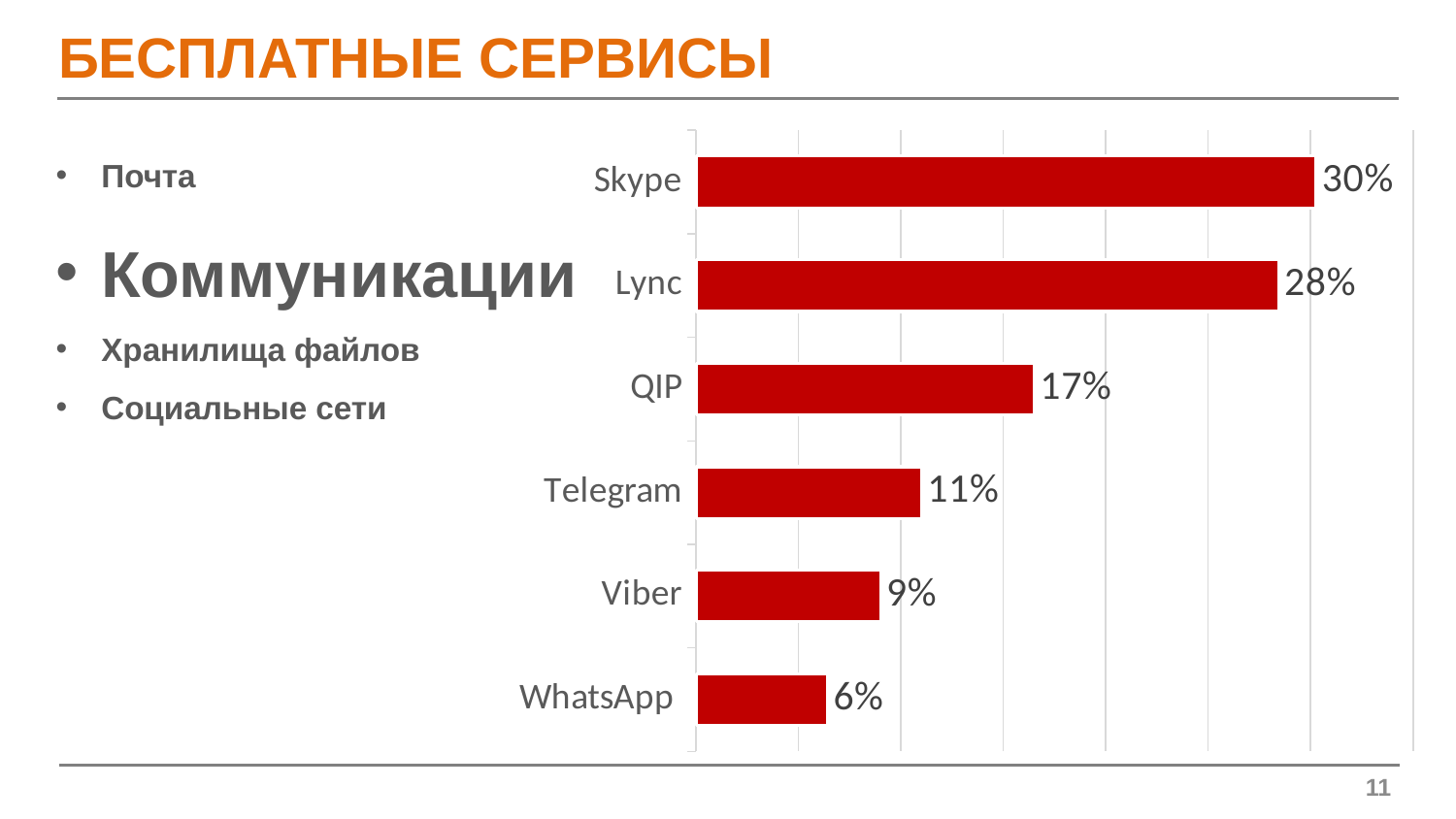
Which category has the highest value? Skype Which is larger, the value for Telegram or the value for Viber? Telegram What is the value for Lync? 28% What kind of chart is shown on the slide? Bar chart How many categories are shown in the chart? 6 What colour are the bars in the chart? Red Which category has the lowest value? WhatsApp What is the difference between the values for Skype and Lync? 2% What is the value for WhatsApp? 6% What is the value for Skype? 30% What is the value for Telegram? 11% What is the difference between the values for QIP and Viber? 8%